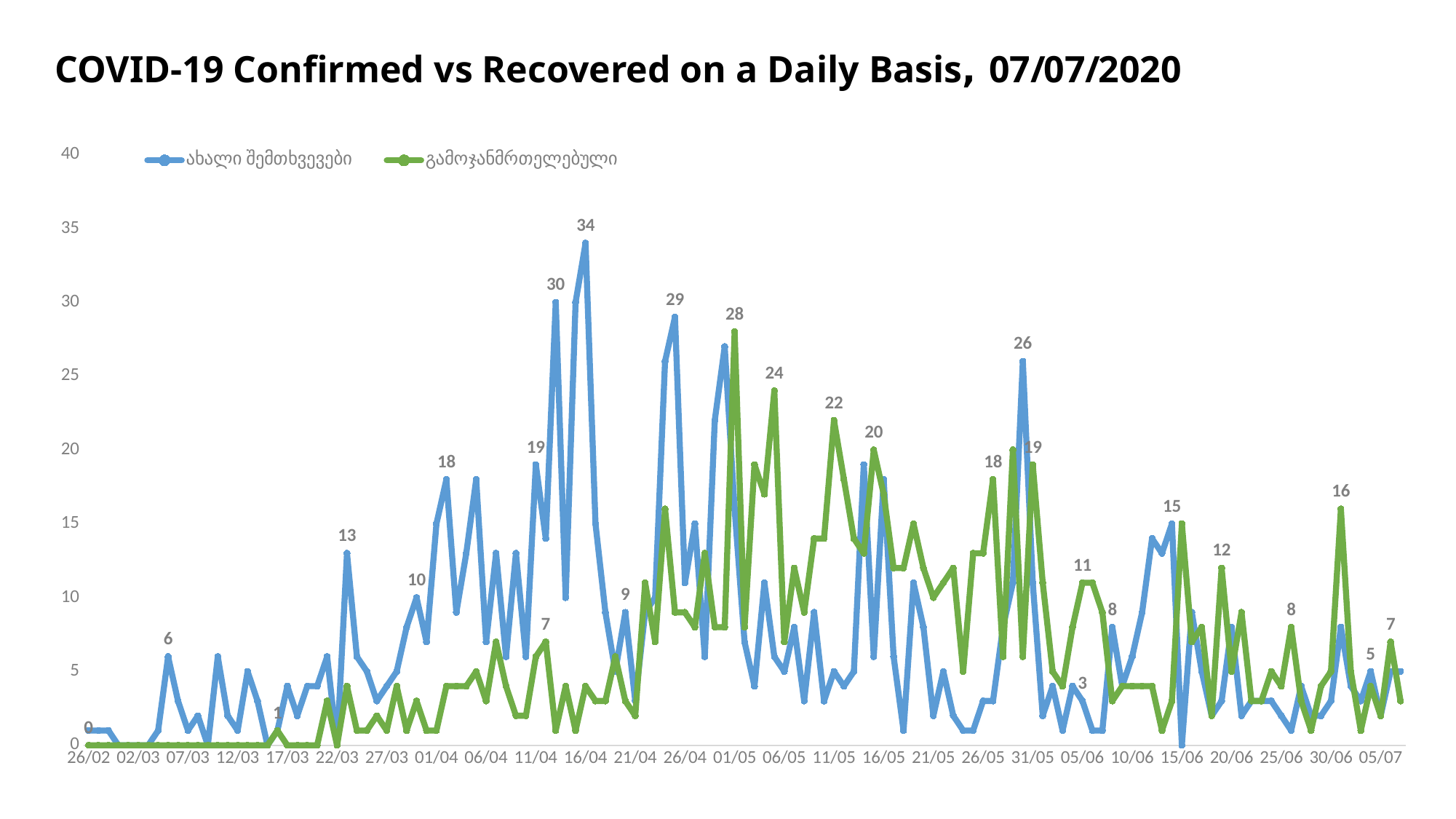
What is the difference between the peak of the blue series (34) and the peak of the green series (28)? 6 What is the title of the chart? COVID-19 Confirmed vs Recovered on a Daily Basis, 07/07/2020 Which series reaches a higher peak value, the blue (confirmed) or the green (recovered)? blue (confirmed) Is the labelled blue peak of 26 at the end of May greater or less than 25? greater Is the highest value of the green (recovered) series greater or less than 30? less What is the highest labelled value of the green (recovered) series? 28 What is the labelled value of the blue series at 26/02, the first date on the x axis? 0 What is the difference between the two labelled blue peaks of 34 and 30 in mid-April? 4 What is the maximum value shown on the vertical axis? 40 What type of chart is shown on the slide? line chart What is the highest labelled value of the blue (confirmed) series? 34 How many series does the legend list? 2